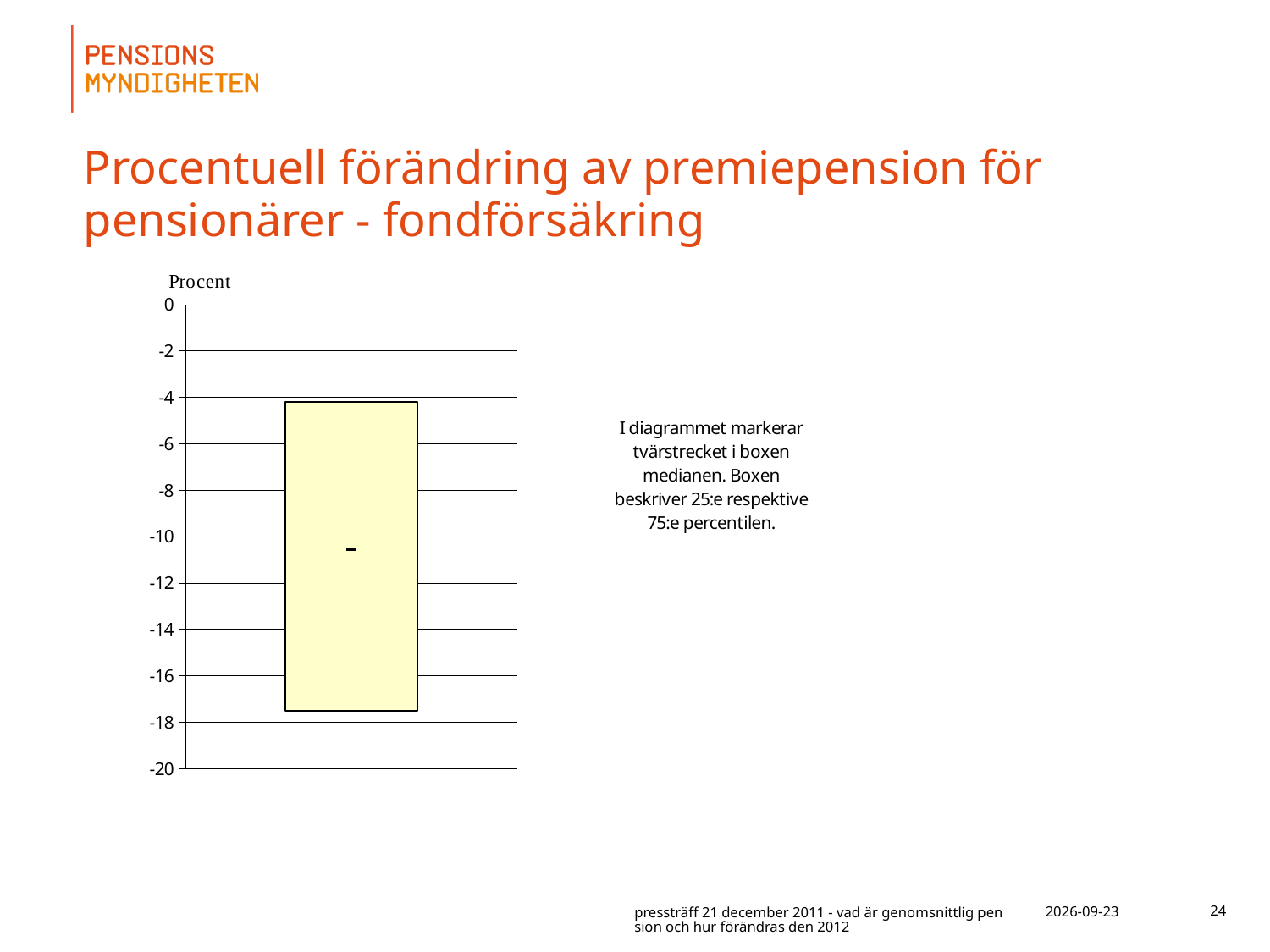
Is the median (the cross line in the box) greater or less than -12? greater Is the top of the box greater or less than -6? greater Are all the values shown in the box greater or less than 0? less What is the lowest value shown on the vertical axis? -20 What kind of chart is shown on the slide? box plot What is the label on the vertical axis of the chart? Procent How many boxes are plotted in the chart? 1